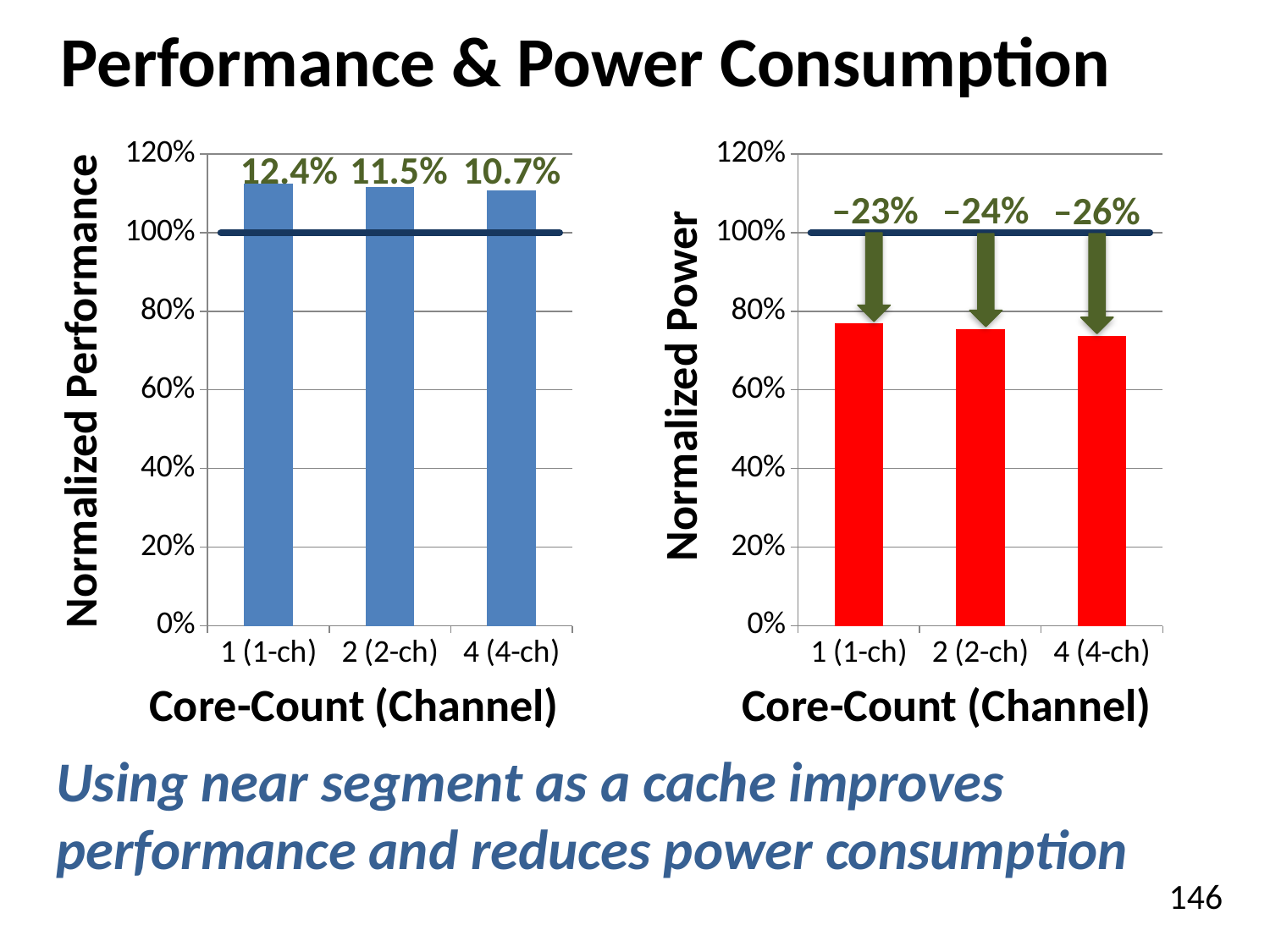
On the Normalized Power chart (right), what reduction is labeled above the 2 (2-ch) bar? –24% On the Normalized Performance chart (left), is the normalized performance for 2 (2-ch) greater or less than 100%? greater On the Normalized Performance chart (left), what improvement is labeled above the 1 (1-ch) bar? 12.4% On the Normalized Performance chart (left), how many core-count configurations are plotted? 3 What is the x-axis title of the Normalized Performance chart (left)? Core-Count (Channel) On the Normalized Power chart (right), which core-count configuration has the lowest normalized power? 4 (4-ch) On the Normalized Power chart (right), do the bar values rise or fall as the core count increases from 1 to 4? fall On the Normalized Performance chart (left), which core-count configuration has the highest normalized performance? 1 (1-ch) On the Normalized Power chart (right), what reduction is labeled above the 4 (4-ch) bar? –26% On the Normalized Performance chart (left), what improvement is labeled above the 4 (4-ch) bar? 10.7% What type of chart is the Normalized Power chart (right)? bar chart On the Normalized Power chart (right), is the normalized power for 1 (1-ch) greater or less than 80%? less